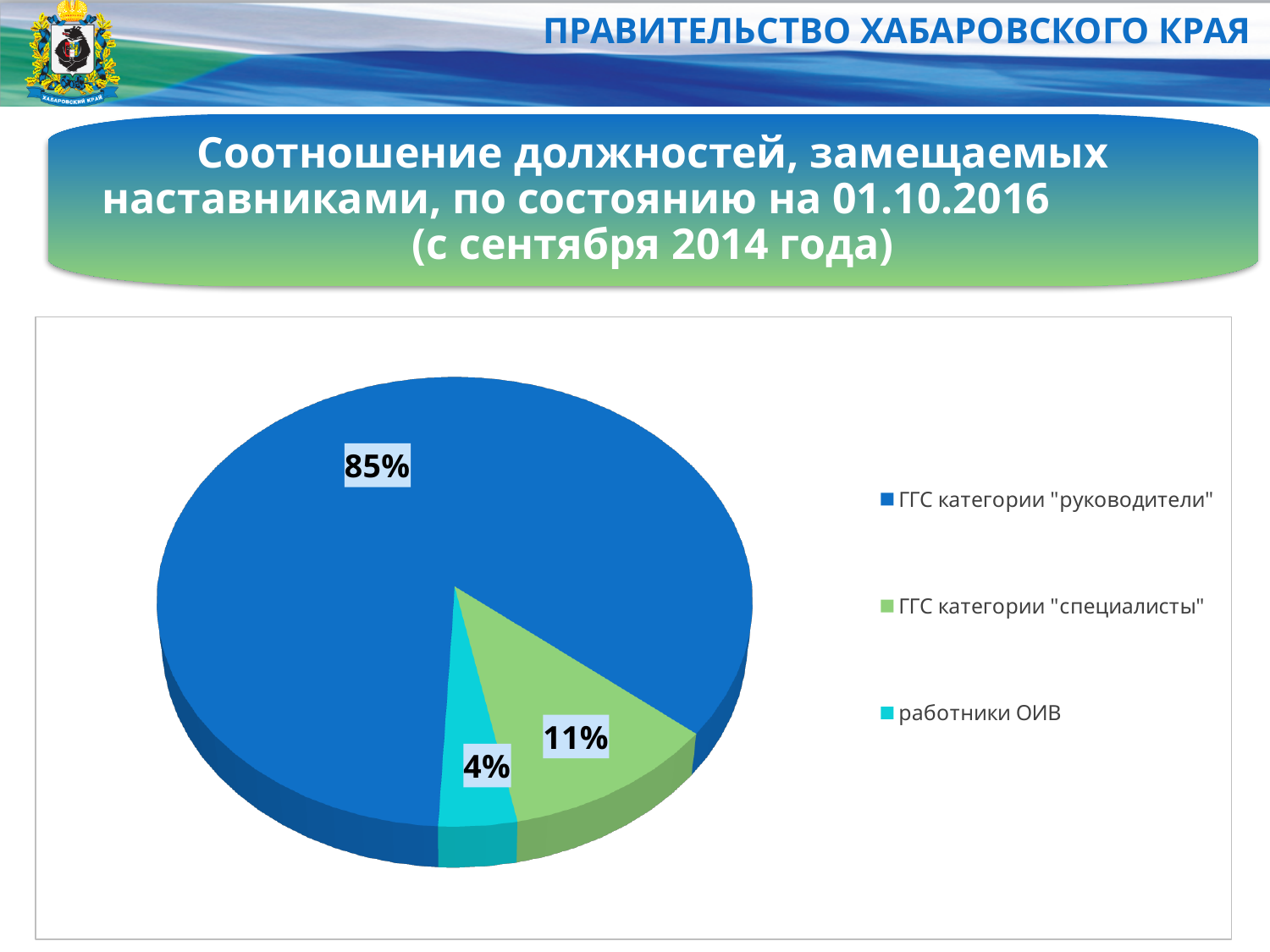
What is the difference in percentage points between ГГС категории "руководители" and ГГС категории "специалисты"? 74 What kind of chart is shown on the slide? pie chart Which category has the largest slice of the pie? ГГС категории "руководители" What share of the pie does работники ОИВ have? 4% How many categories does the pie chart show? 3 What colour is the slice for работники ОИВ? cyan Which category has the smallest slice of the pie? работники ОИВ Which is larger: the share for ГГС категории "специалисты" or the share for работники ОИВ? ГГС категории "специалисты" What share of the pie does ГГС категории "руководители" have? 85% What share of the pie does ГГС категории "специалисты" have? 11% How many entries does the legend list? 3 What is the difference in percentage points between ГГС категории "специалисты" and работники ОИВ? 7